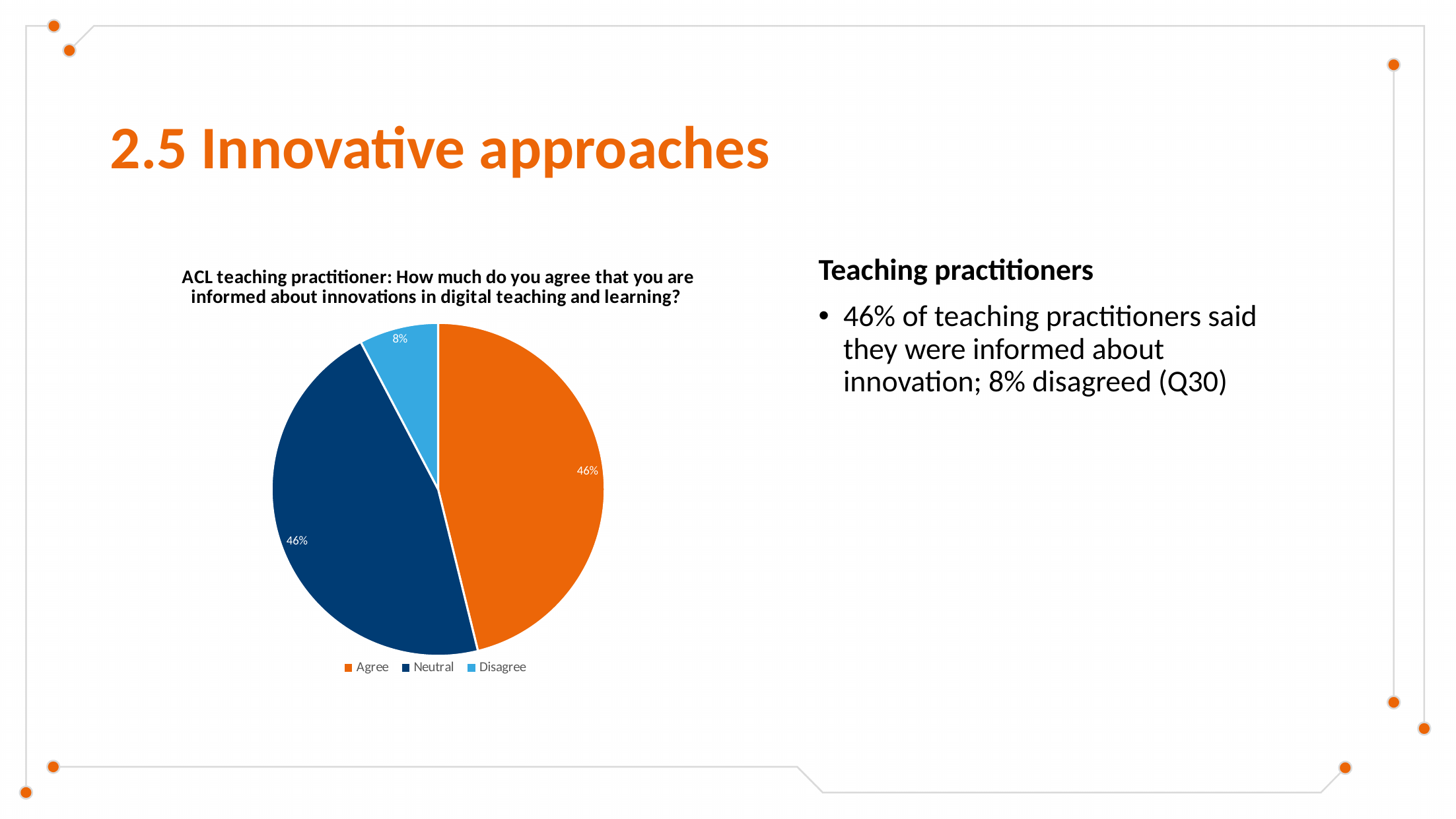
What is the difference in percentage points between the Agree slice and the Disagree slice? 38 What percentage of the pie chart is labelled Disagree? 8% How many entries does the legend of the pie chart list? 3 Which category has the smallest slice of the pie chart? Disagree How many slices does the pie chart have? 3 What percentage of the pie chart is labelled Neutral? 46% Which colour represents Neutral in the pie chart? Dark blue What kind of chart is shown on the slide? Pie chart What percentage of the pie chart is labelled Agree? 46% Which is larger in the pie chart, the Agree slice or the Disagree slice? Agree What share of the pie does the Disagree slice represent? 8% What is the title of the pie chart? ACL teaching practitioner: How much do you agree that you are informed about innovations in digital teaching and learning?